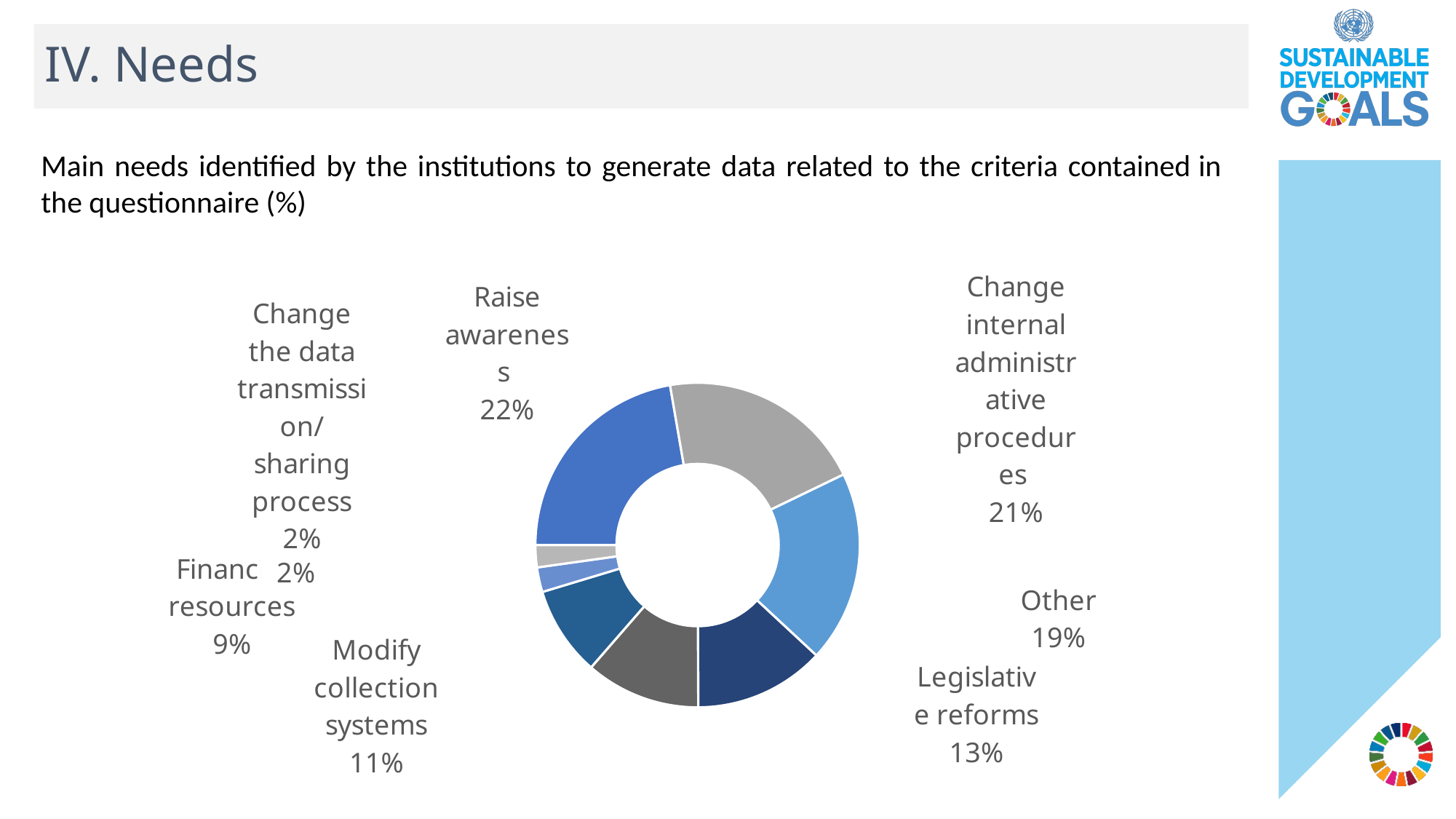
What is the value for Financ resources in the chart? 9% What percentage of the doughnut chart is for Raise awareness? 22% What percentage is shown for Modify collection systems? 11% Which is larger, the share for Other or the share for Modify collection systems? Other What share does Change internal administrative procedures have in the chart? 21% How many slices does the chart have? 8 What percentage is shown for Other? 19% What is the difference between the shares for Change internal administrative procedures and Financ resources? 12% What is the difference between the shares for Raise awareness and Legislative reforms? 9% Which need has the largest share in the chart? Raise awareness What is the value shown for Legislative reforms? 13% What kind of chart is shown on the slide? Doughnut chart